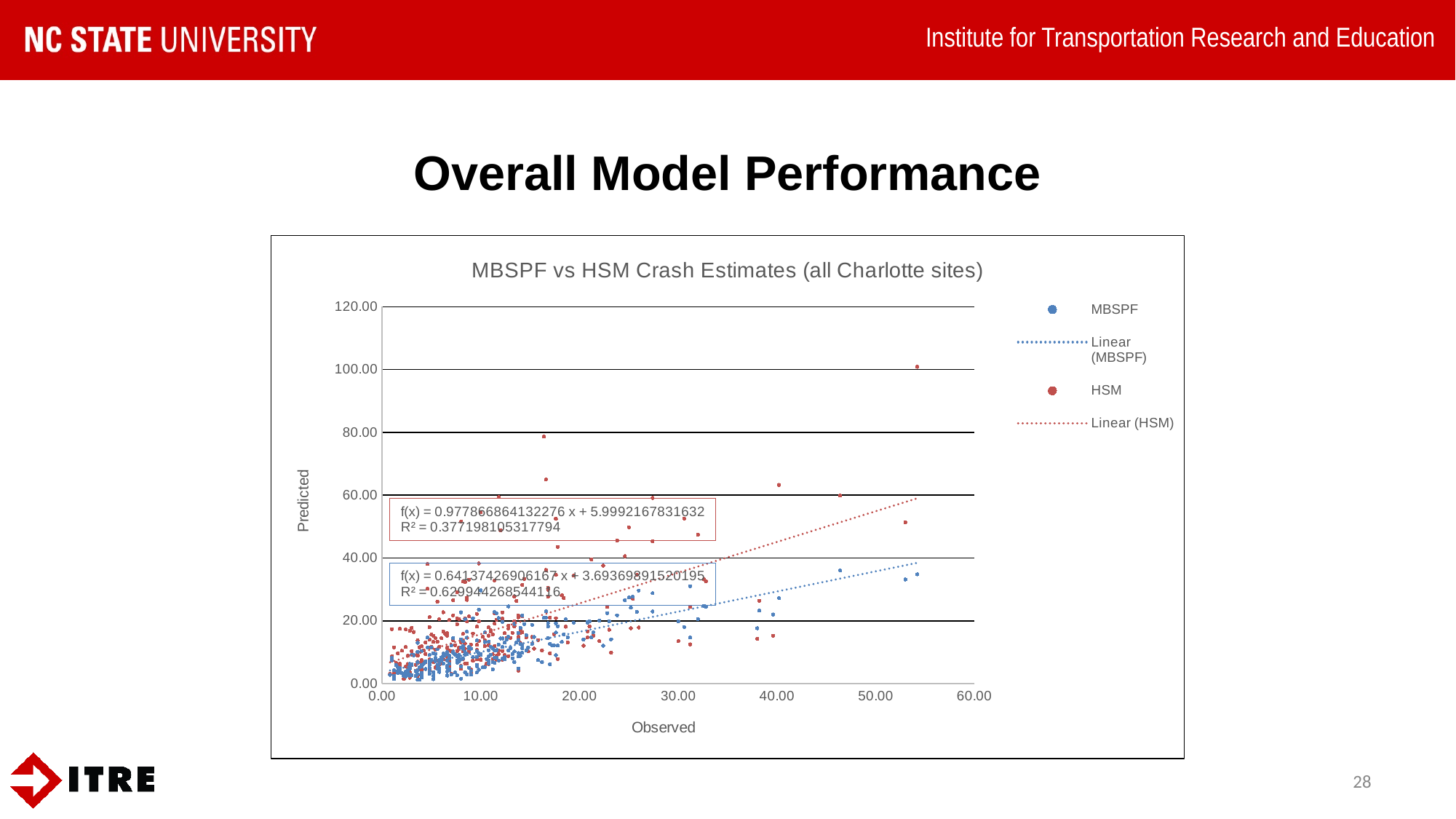
What R² value is printed in the lower equation box? 0.629944268544116 What is the label of the vertical axis? Predicted What is the highest tick value shown on the vertical axis? 120.00 Do the dotted trend lines rise or fall as the Observed value increases? Rise What is the label of the horizontal axis? Observed What is the title of the chart? MBSPF vs HSM Crash Estimates (all Charlotte sites) What R² value is printed in the upper equation box? 0.377198105317794 What kind of chart is shown on the slide? Scatter chart How many entries does the chart legend list? 4 Which trend line is steeper, Linear (HSM) or Linear (MBSPF)? Linear (HSM) What is the highest tick value shown on the horizontal axis? 60.00